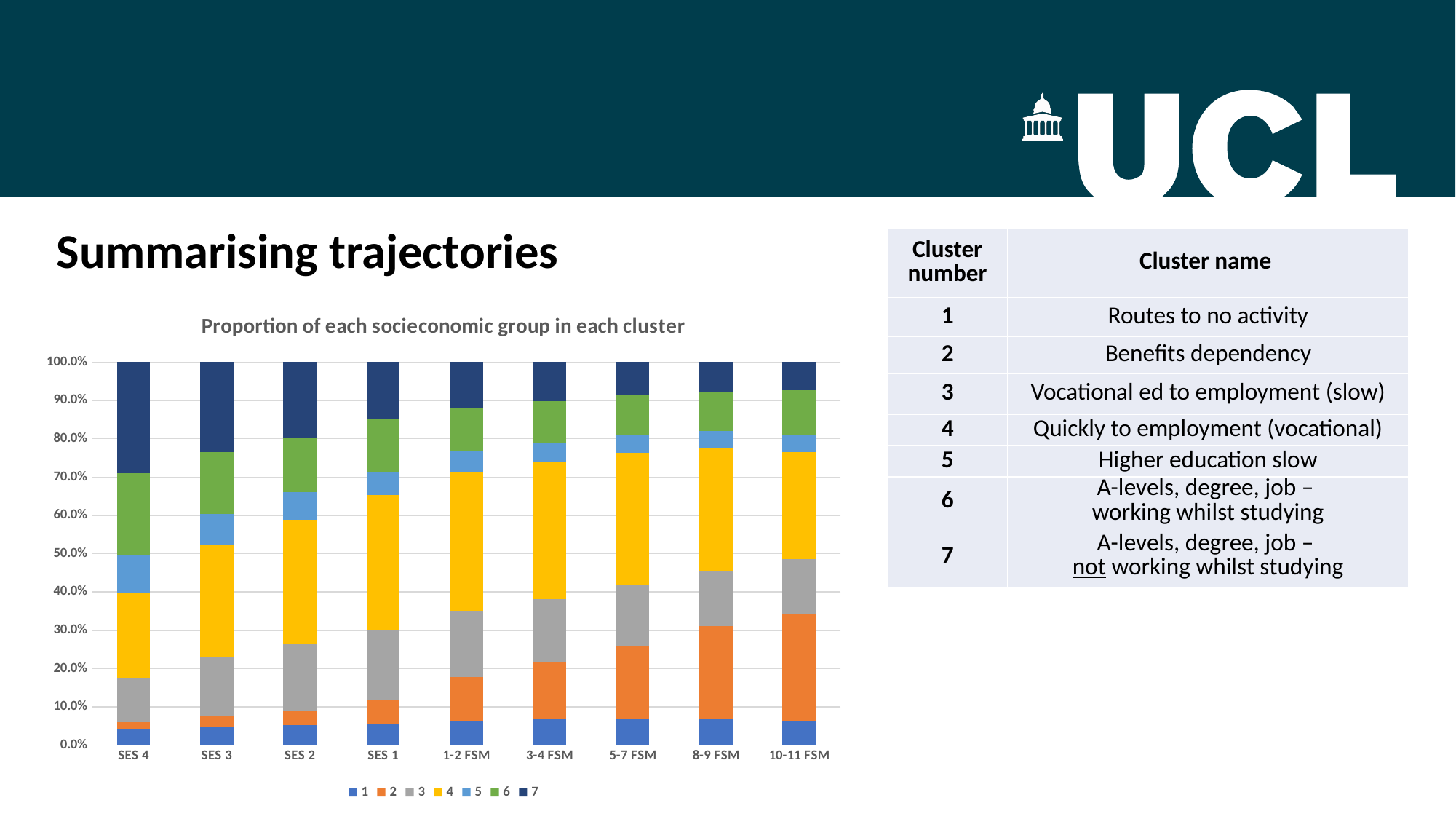
What is the total height of the SES 4 stacked bar? 100.0% What is the title of the chart? Proportion of each socieconomic group in each cluster Is the share of cluster 4 in the 1-2 FSM bar greater or less than 30%? greater Is the share of cluster 7 in the SES 4 bar greater or less than 20%? greater What kind of chart is shown on the slide? Stacked bar chart Is the share of cluster 2 in the 10-11 FSM bar greater or less than 20%? greater Moving from SES 4 to 10-11 FSM along the x axis, does the share of cluster 2 rise or fall? rise How many socioeconomic group categories are shown on the x axis of the chart? 9 How many series does the chart's legend list? 7 Which category has the largest share for cluster 7? SES 4 Which category has the largest share for cluster 2? 10-11 FSM